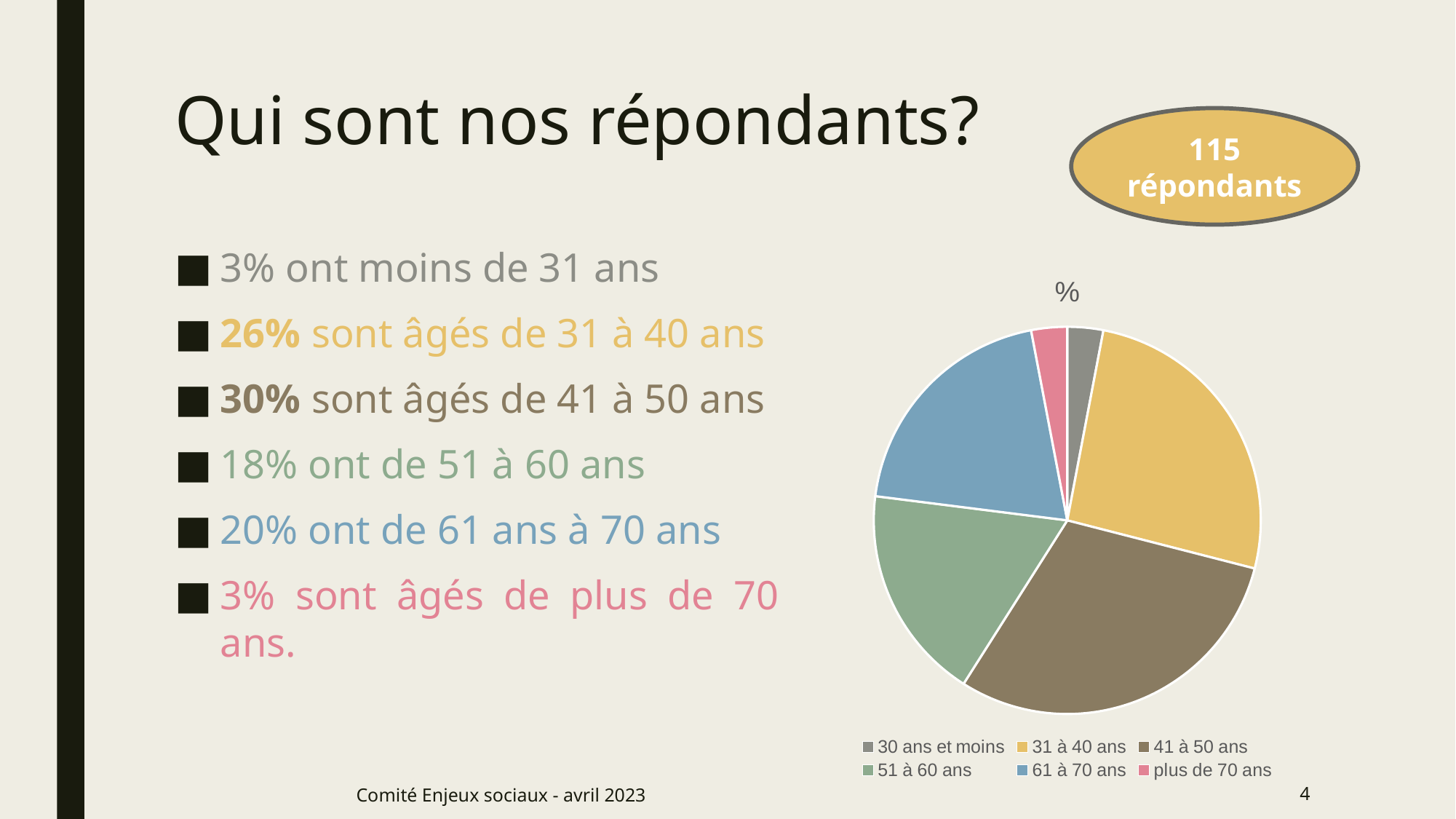
What is the difference in percentage points between the '41 à 50 ans' and '31 à 40 ans' slices? 4 What is the title shown above the pie chart? % Which age category has the largest slice of the pie chart? 41 à 50 ans Which slice is larger: '31 à 40 ans' or '51 à 60 ans'? 31 à 40 ans What percentage of respondents are in the '31 à 40 ans' category? 26% What percentage of respondents are in the '51 à 60 ans' category? 18% What kind of chart is shown on the slide? Pie chart What colour is the '31 à 40 ans' slice in the pie chart? Yellow What percentage of respondents are in the '41 à 50 ans' category? 30% What percentage of respondents are in the '61 à 70 ans' category? 20% How many categories does the pie chart's legend list? 6 What percentage of respondents are in the 'plus de 70 ans' category? 3%